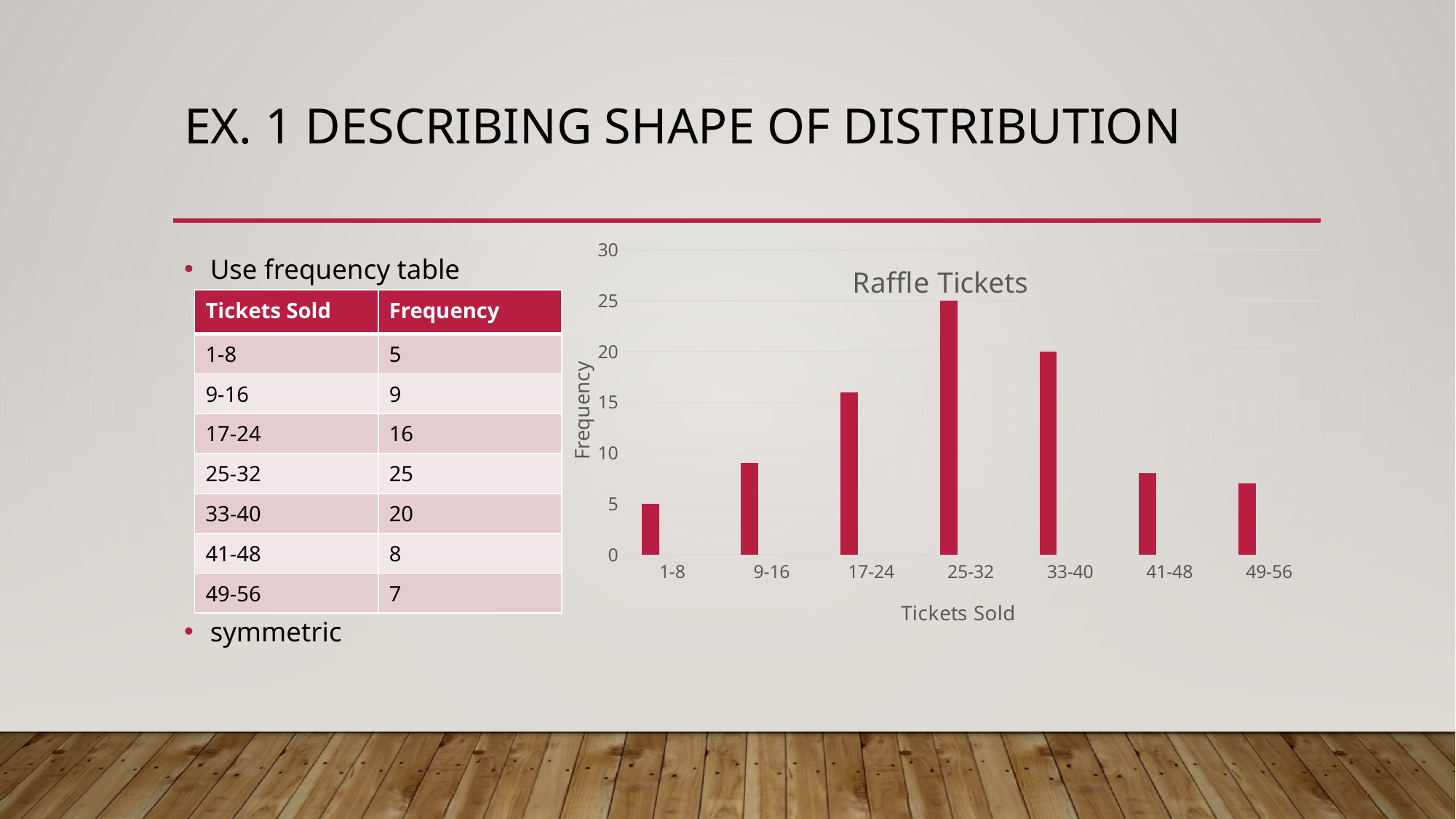
What is the title of the chart? Raffle Tickets Is the frequency for the 17-24 category greater or less than 15? greater What type of chart is shown on the slide? bar chart What is the frequency for the 33-40 category in the chart? 20 What is the frequency for the 1-8 category in the chart? 5 What is the difference in frequency between the 25-32 and 33-40 categories? 5 Which has a higher frequency in the chart, 9-16 or 41-48? 9-16 What is the frequency for the 25-32 category in the chart? 25 How many ticket-sold categories are plotted on the x axis of the chart? 7 Is the frequency for the 49-56 category greater or less than 10? less Which ticket-sold category has the lowest frequency in the chart? 1-8 Which ticket-sold category has the highest frequency in the chart? 25-32